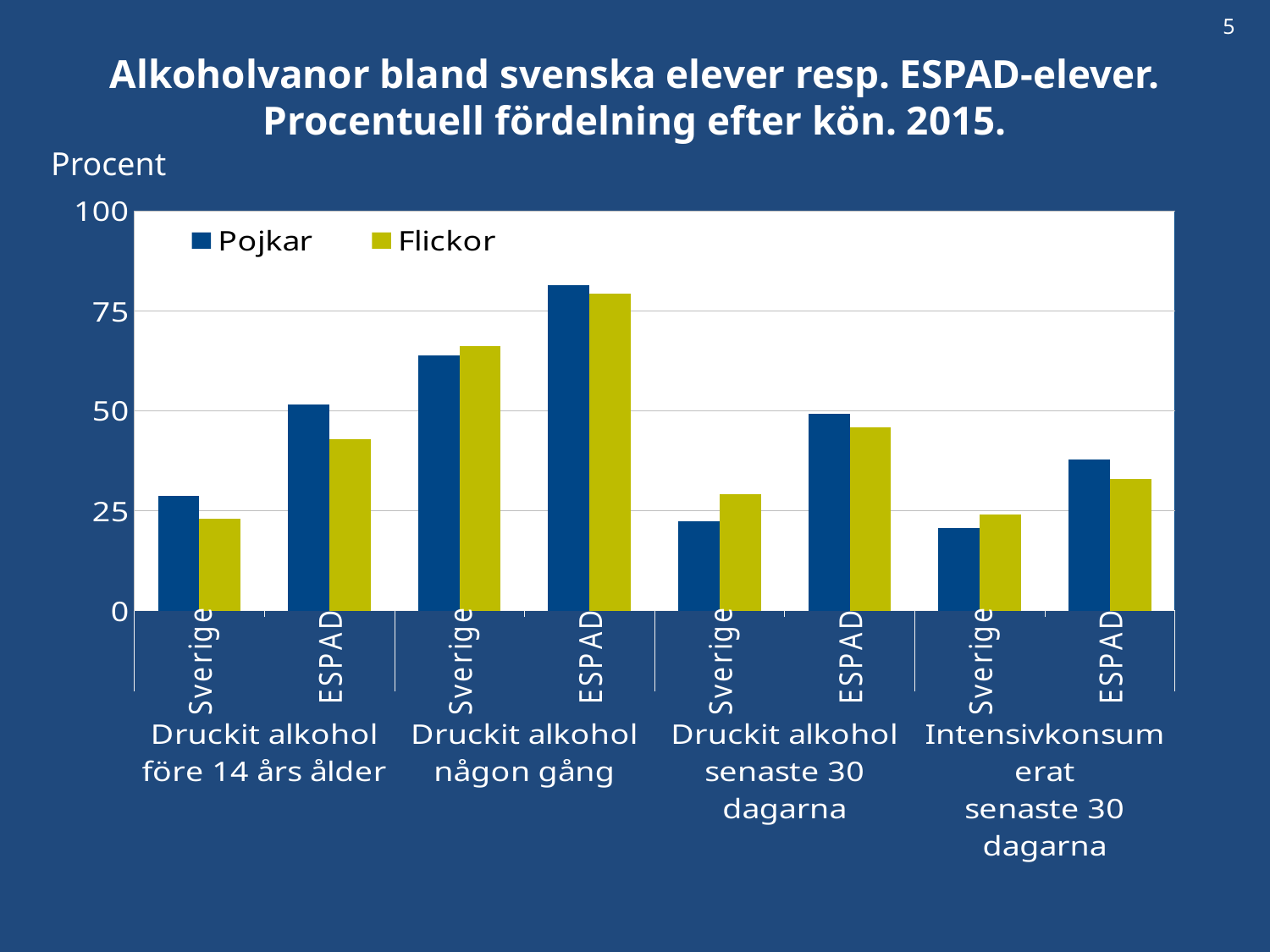
How many main category groups are shown along the x axis? 4 Is the value for Flickor in ESPAD for 'Intensivkonsumerat senaste 30 dagarna' greater or less than 25? greater Is the value for Flickor in Sverige for 'Druckit alkohol före 14 års ålder' greater or less than 25? less For 'Druckit alkohol före 14 års ålder' in ESPAD, which is larger, Pojkar or Flickor? Pojkar What are the two series named in the legend? Pojkar and Flickor How many series does the legend list? 2 Is the value for Pojkar in ESPAD for 'Druckit alkohol någon gång' greater or less than 75? greater Which bar is the highest in the chart? Pojkar, ESPAD, Druckit alkohol någon gång For 'Druckit alkohol senaste 30 dagarna' in Sverige, which is larger, Pojkar or Flickor? Flickor What kind of chart is shown on the slide? bar chart